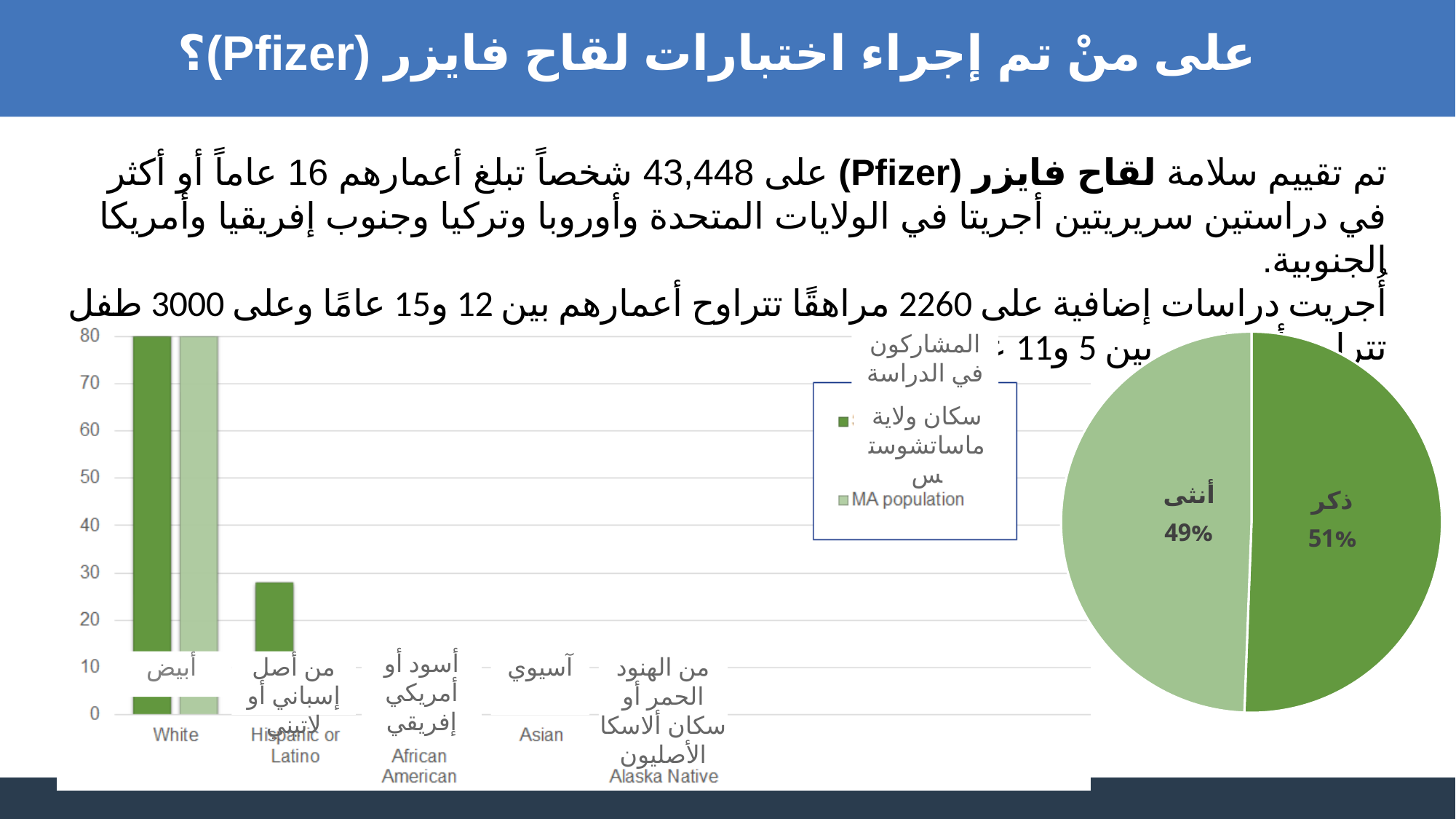
What kind of chart is the chart on the left of the slide? Bar chart In the bar chart on the left, is the value of the light green bar for White greater or less than 70? greater In the bar chart on the left, is the value of the dark green bar for Hispanic or Latino greater or less than 20? greater In the pie chart on the right, what share is shown for أنثى (female)? 49% In the pie chart on the right, what share is shown for ذكر (male)? 51% In the pie chart on the right, how many slices are there? 2 In the pie chart on the right, what is the difference between the ذكر and أنثى shares? 2% In the bar chart on the left, what is the English label of the light green legend entry? MA population In the bar chart on the left, is the value of the dark green bar for Hispanic or Latino greater or less than 30? less In the pie chart on the right, which slice is larger, ذكر or أنثى? ذكر In the bar chart on the left, how many series does the legend list? 2 What kind of chart is the chart on the right of the slide? Pie chart